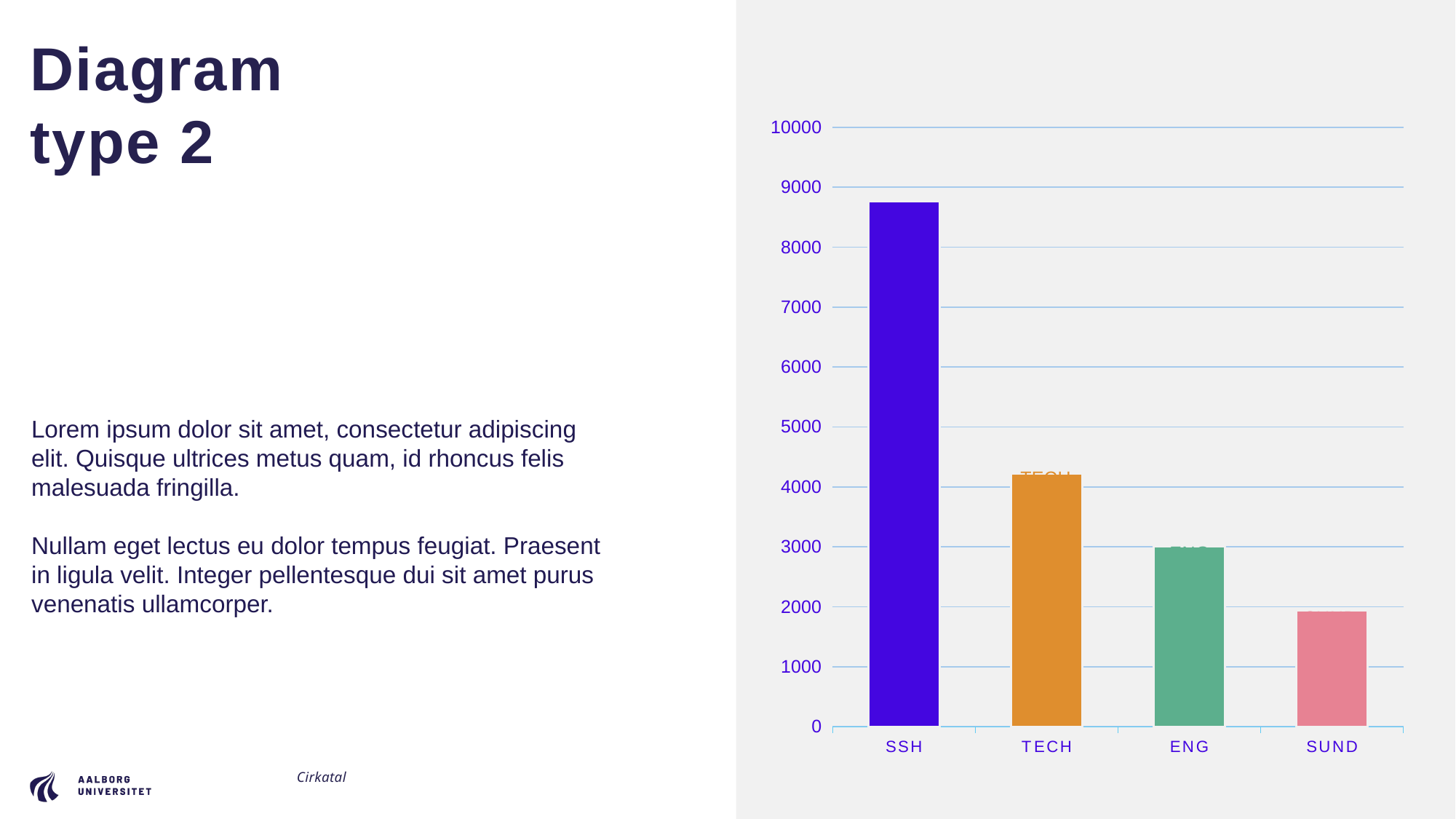
What kind of chart is shown on the slide? bar chart Which category has the lowest bar in the chart? SUND Is the value for TECH greater or less than 5000? less Is the value for SSH greater or less than 8000? greater Which is larger, the value for ENG or the value for SUND? ENG Which category has the highest bar in the chart? SSH Is the value for TECH greater or less than 4000? greater How many categories are shown on the x axis of the chart? 4 Which is larger, the value for SSH or the value for TECH? SSH What is the highest value shown on the chart's vertical axis? 10000 Do the bar values rise or fall from left to right across the x axis? fall